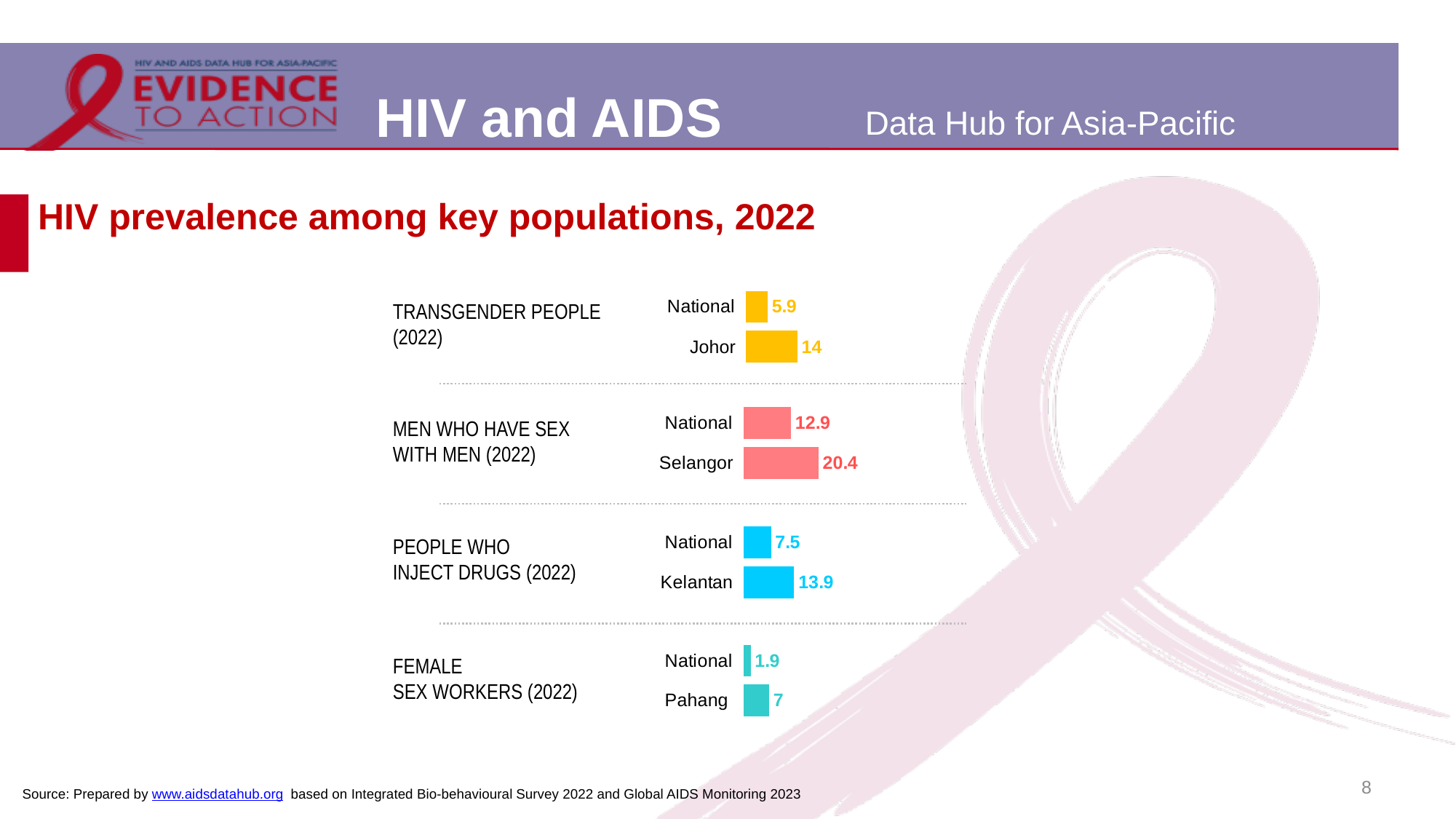
In the Female Sex Workers (2022) chart, which is larger, the Pahang value or the National value? Pahang In the People Who Inject Drugs (2022) chart, what is the value for Kelantan? 13.9 What kind of chart is used to show the HIV prevalence values on this slide? Bar chart In the Female Sex Workers (2022) chart, what is the National value? 1.9 In the Men Who Have Sex With Men (2022) chart, what is the National value? 12.9 In the Men Who Have Sex With Men (2022) chart, what is the difference between the Selangor and National values? 7.5 In the Transgender People (2022) chart, what is the value for Johor? 14 In the Transgender People (2022) chart, what is the difference between the Johor and National values? 8.1 Across all four charts on the slide, which bar has the lowest value? National (Female Sex Workers), 1.9 How many bars are shown in the Men Who Have Sex With Men (2022) chart? 2 Across all four charts on the slide, which bar has the highest value? Selangor (Men Who Have Sex With Men), 20.4 In the People Who Inject Drugs (2022) chart, which bar is the highest? Kelantan